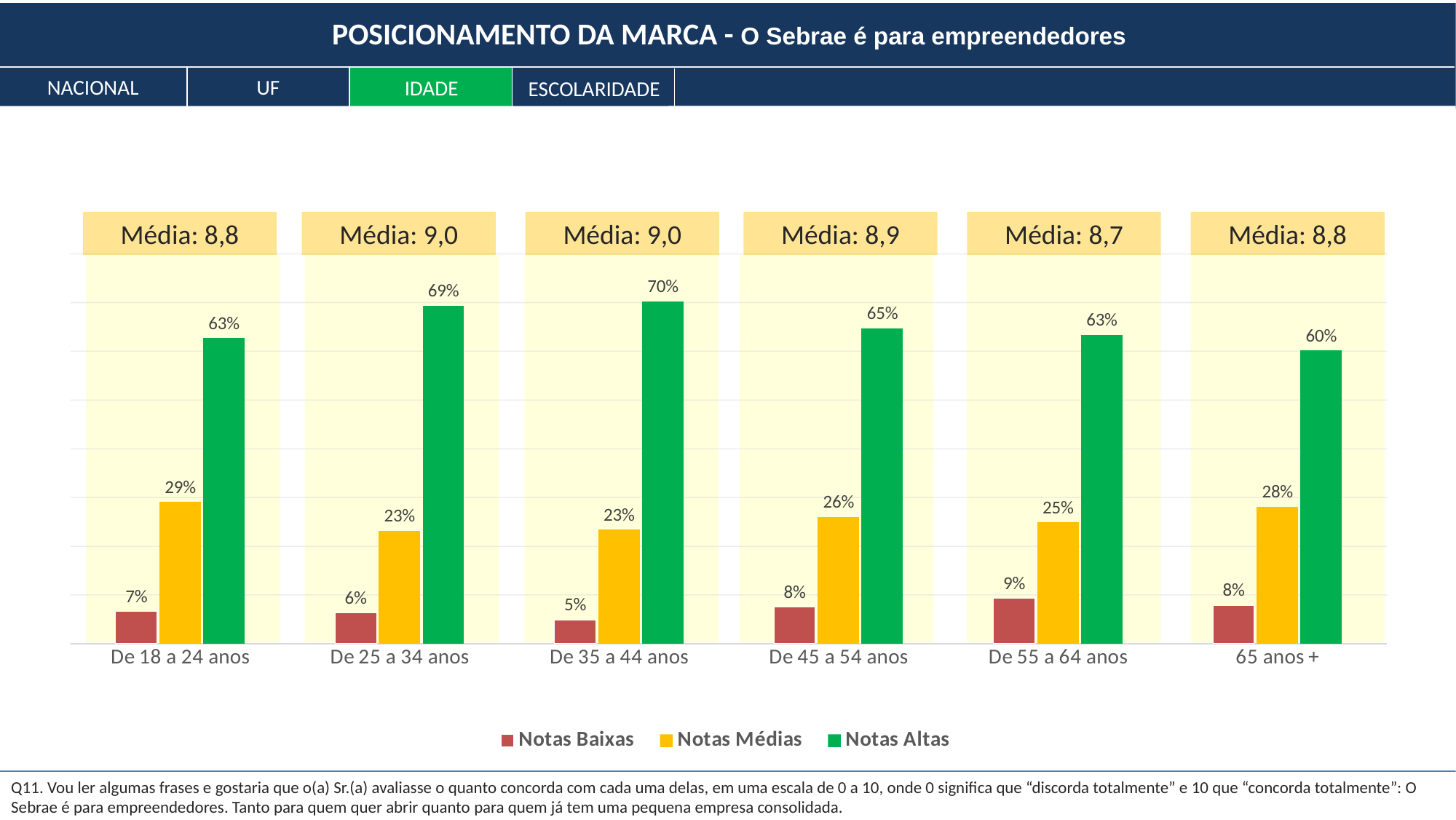
How many series does the legend list? 3 What is the value of Notas Altas for the De 35 a 44 anos age group? 70% What is the value of Notas Médias for the De 18 a 24 anos age group? 29% Which age group has the highest Notas Altas value? De 35 a 44 anos What kind of chart is shown on the slide? Bar chart Which is larger: Notas Médias for De 45 a 54 anos or Notas Médias for De 55 a 64 anos? De 45 a 54 anos How many age groups are shown on the x axis? 6 What is the difference between the Notas Altas values for De 25 a 34 anos and 65 anos +? 9% Which colour represents Notas Altas in the legend? Green What is the Média shown above the De 55 a 64 anos age group? 8,7 What is the value of Notas Baixas for the De 55 a 64 anos age group? 9% Which age group has the lowest Notas Baixas value? De 35 a 44 anos